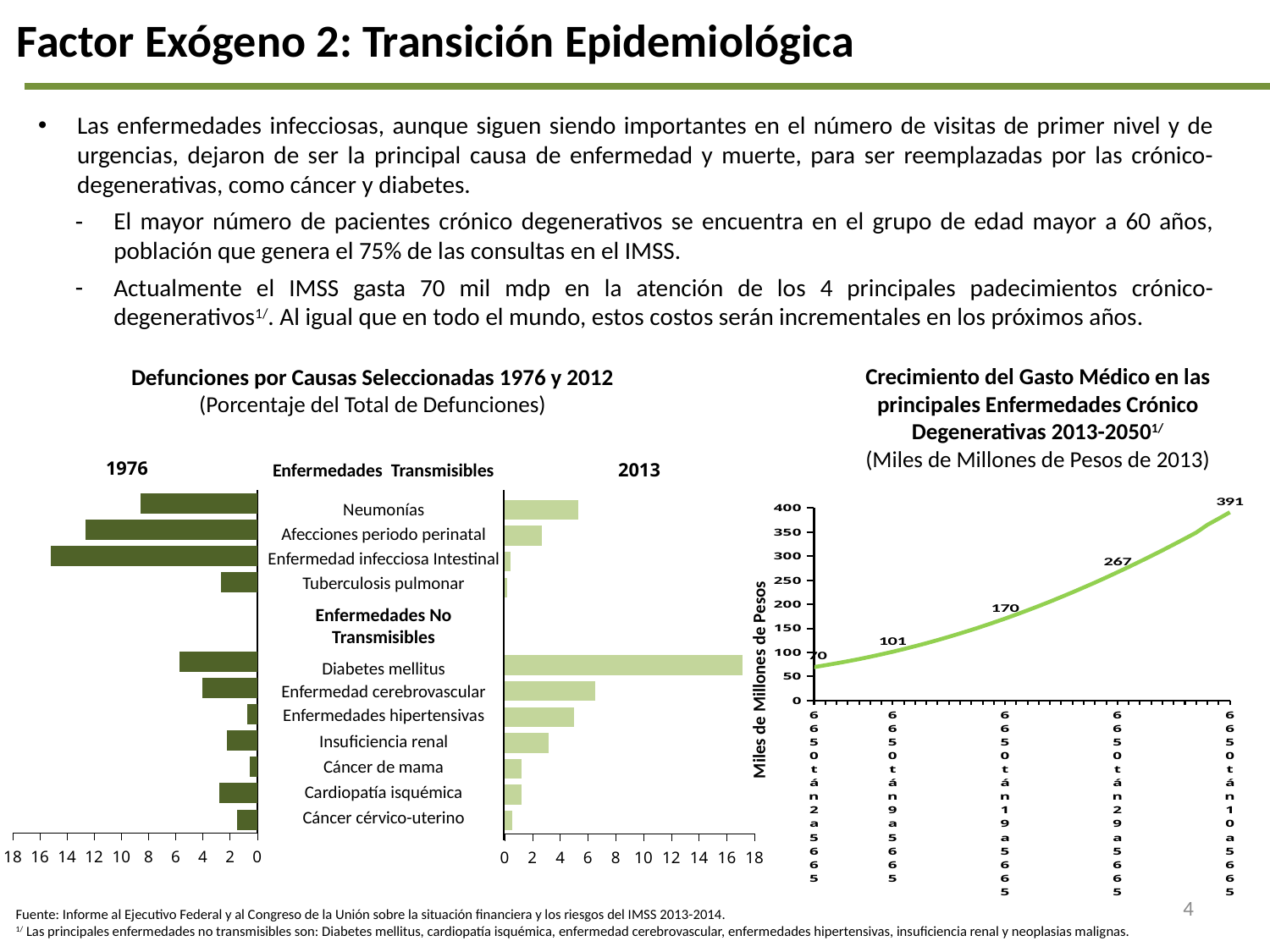
What kind of chart is the 'Crecimiento del Gasto Médico en las principales Enfermedades Crónico Degenerativas 2013-2050' chart? line chart In the 'Defunciones por Causas Seleccionadas' chart, which is larger in 2013: Neumonías or Afecciones periodo perinatal? Neumonías In the 'Defunciones por Causas Seleccionadas' chart, which cause has the highest percentage in 1976? Enfermedad infecciosa Intestinal In the 'Crecimiento del Gasto Médico' chart, how many data points have value labels? 5 In the 'Crecimiento del Gasto Médico' chart, do the values rise or fall along the x axis? rise In the 'Defunciones por Causas Seleccionadas' chart, is the 2013 value for Diabetes mellitus greater or less than 14? greater In the 'Crecimiento del Gasto Médico' chart, what is the highest labeled value? 391 In the 'Crecimiento del Gasto Médico' chart, what is the difference between the highest labeled value (391) and the lowest labeled value (70)? 321 In the 'Defunciones por Causas Seleccionadas' chart, which cause has the highest percentage in 2013? Diabetes mellitus What kind of chart is the 'Defunciones por Causas Seleccionadas 1976 y 2012' chart? bar chart In the 'Crecimiento del Gasto Médico' chart, what is the lowest labeled value? 70 What is the y-axis title of the 'Crecimiento del Gasto Médico' chart? Miles de Millones de Pesos